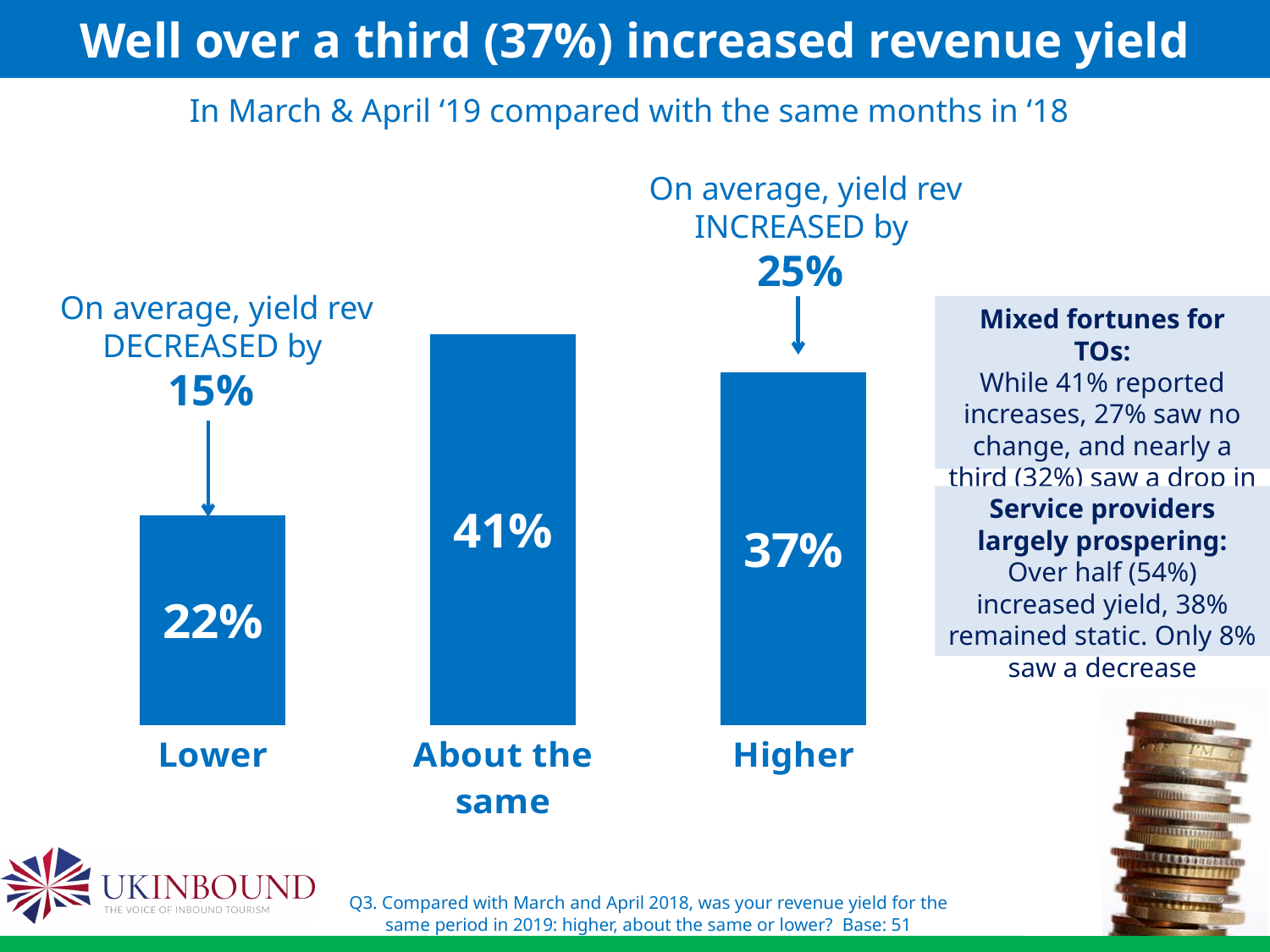
What is the difference in percentage points between About the same and Lower? 19 What is the difference in percentage points between Higher and Lower? 15 According to the annotation above the Higher bar, by how much did yield revenue increase on average? 25% According to the annotation above the Lower bar, by how much did yield revenue decrease on average? 15% Which is larger, the value for Higher or the value for Lower? Higher What percentage of respondents reported revenue yield was Lower? 22% How many categories are shown in the chart? 3 Which category has the lowest percentage? Lower Which category has the highest percentage? About the same What percentage of respondents reported revenue yield was Higher? 37% What percentage of respondents reported revenue yield was About the same? 41% What kind of chart is shown on the slide? Bar chart